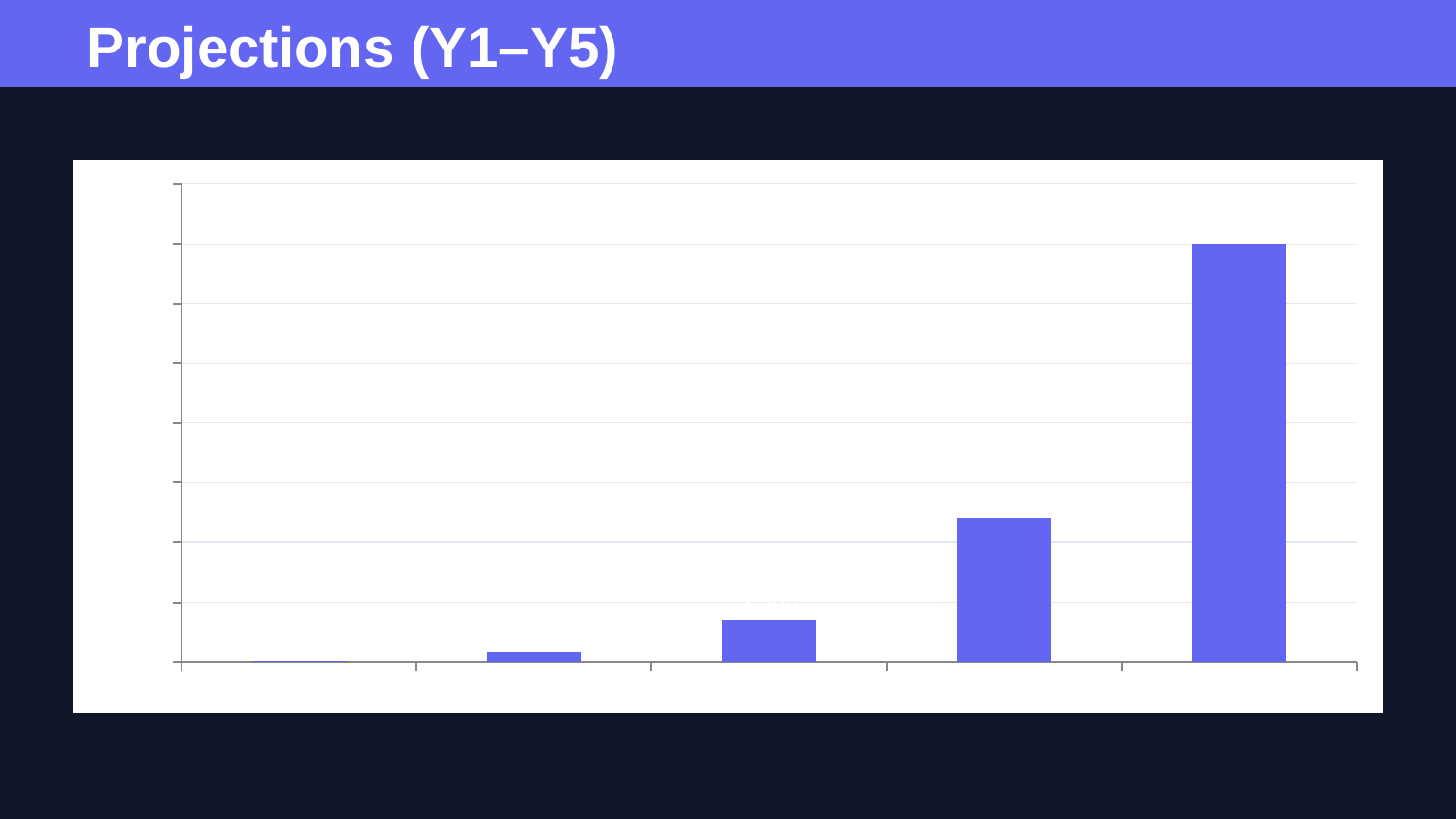
What is the title of the slide containing the chart? Projections (Y1–Y5) What kind of chart is shown on the slide? bar chart What colour are the bars in the chart? blue Do the bar values rise or fall from left to right along the x axis? rise